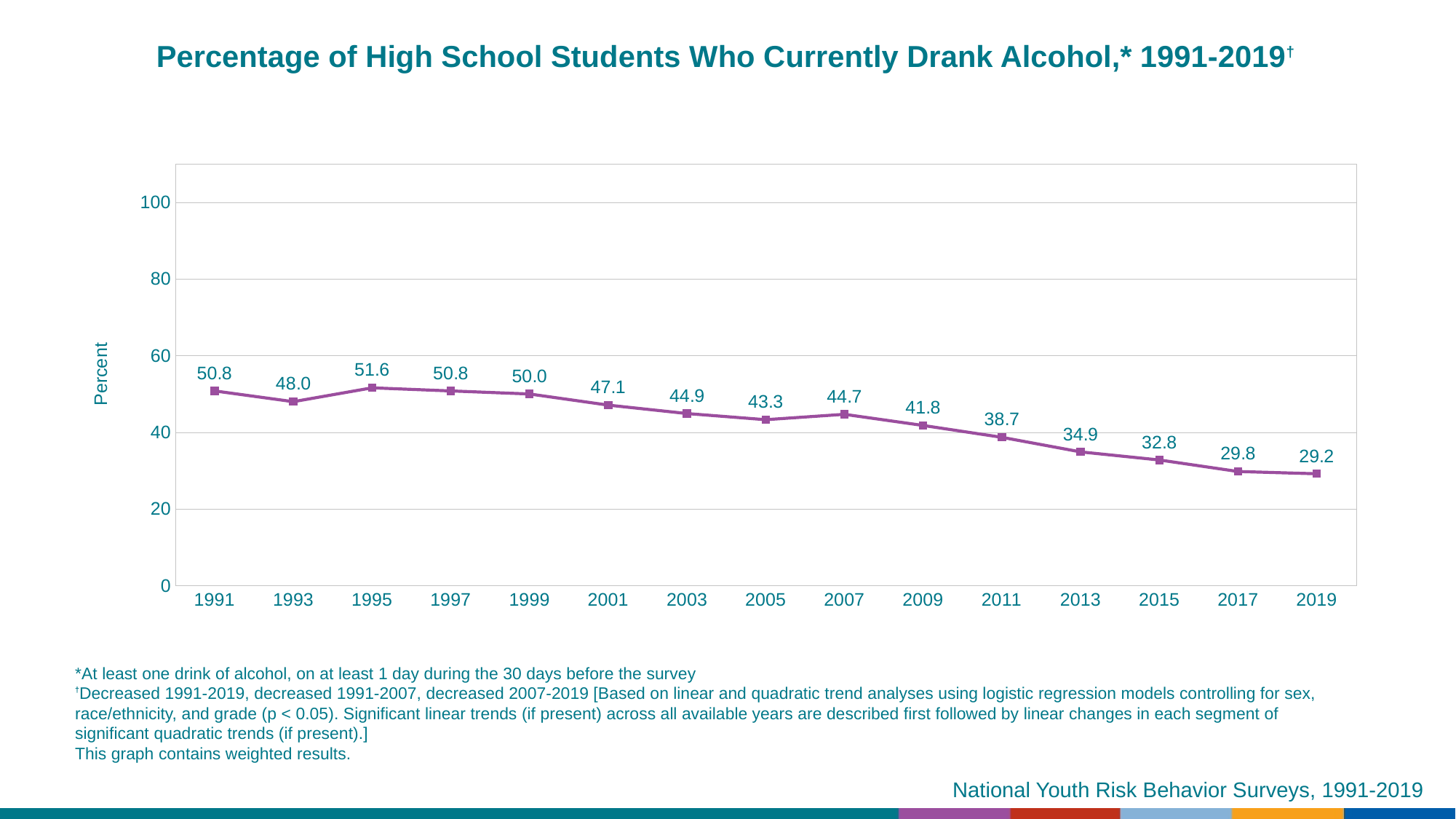
What value is shown for 2007? 44.7 What was the percentage of high school students who currently drank alcohol in 2019? 29.2 Which year has the lowest percentage? 2019 What is the difference between the 2005 value and the 2007 value? 1.4 Which year has the highest percentage? 1995 How many years are plotted on the chart? 15 Which is larger, the value for 2001 or the value for 2011? 2001 What was the percentage of high school students who currently drank alcohol in 1991? 50.8 Do the values generally rise or fall from 1991 to 2019? fall What kind of chart is this? line chart What is the difference between the 1991 value and the 2019 value? 21.6 Is the value for 2013 greater or less than 40? less